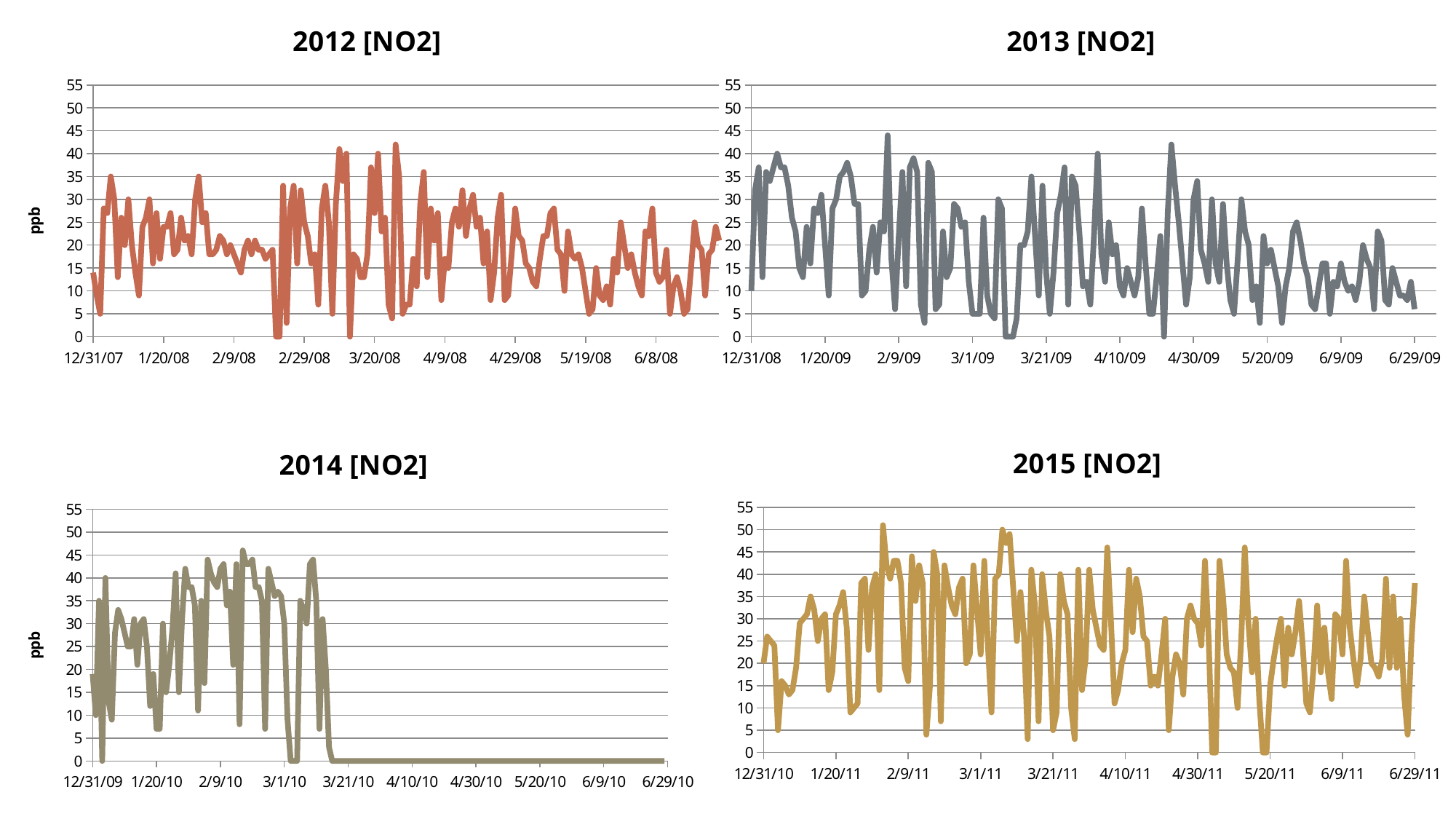
What is the y-axis label on the '2014 [NO2]' chart? ppb In the '2012 [NO2]' chart, is the highest peak greater or less than 45? less In the '2013 [NO2]' chart, is the value at 6/29/09 greater or less than 10? less In the '2014 [NO2]' chart, what value does the line hold from late March 2010 through 6/29/10? 0 What is the highest tick value on the y axis of the '2015 [NO2]' chart? 55 In the '2013 [NO2]' chart, is the highest peak greater or less than 40? greater How many charts are shown on the slide? 4 Which of the four charts reaches the highest peak value? 2015 [NO2] In the '2013 [NO2]' chart, do the values generally rise or fall from January to June 2009? fall What kind of chart is the '2012 [NO2]' chart? line chart